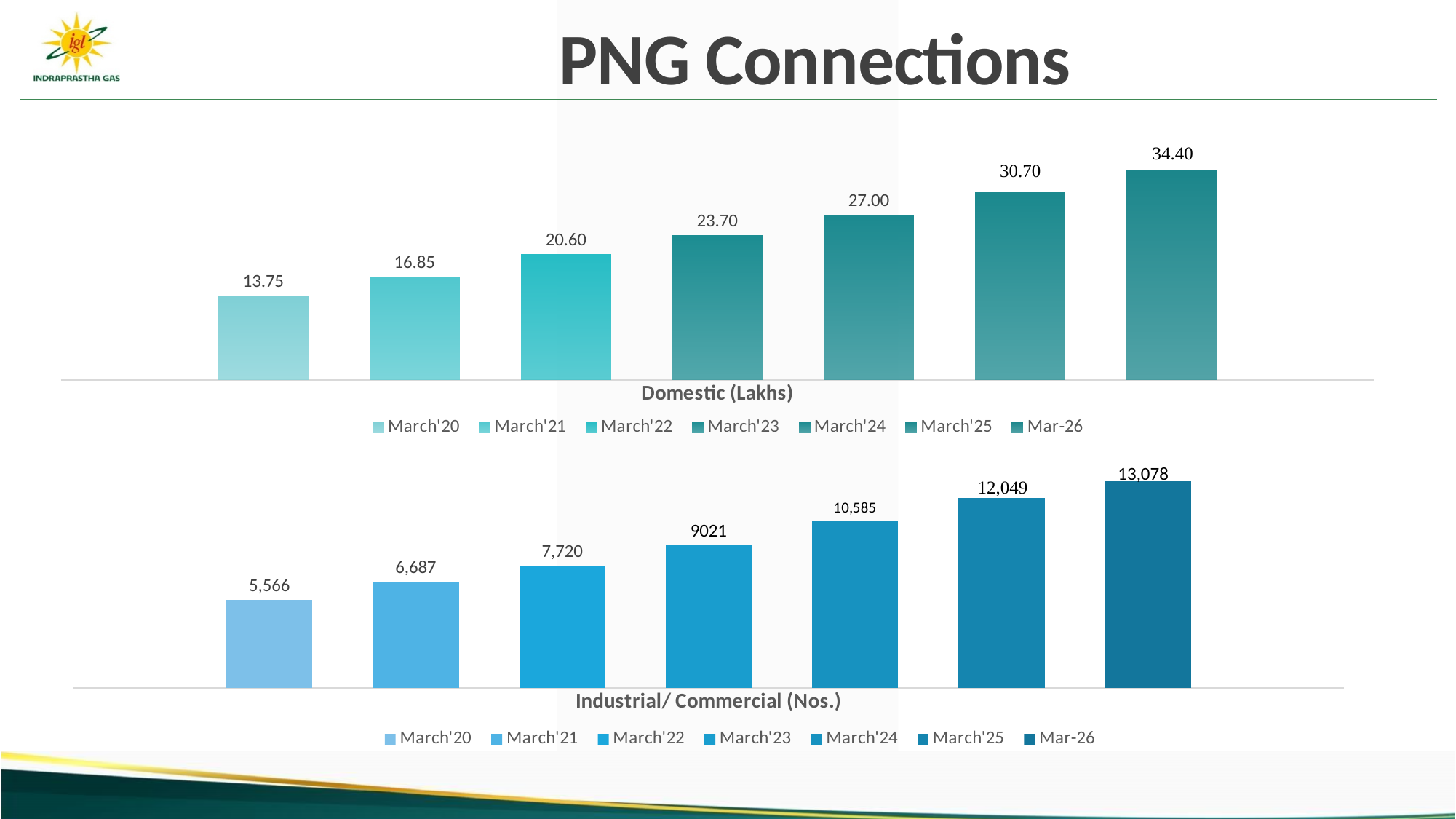
In the Industrial/ Commercial (Nos.) chart, what is the difference between the March'25 and March'24 values? 1,464 In the Industrial/ Commercial (Nos.) chart, what is the value for March'20? 5,566 In the Industrial/ Commercial (Nos.) chart, what is the value for March'23? 9021 In the Domestic (Lakhs) chart, which is larger, the value for March'23 or the value for March'21? March'23 In the Domestic (Lakhs) chart, what is the value for March'22? 20.60 What kind of chart is the Domestic (Lakhs) chart? Bar chart In the Domestic (Lakhs) chart, which series has the lowest value? March'20 How many series does the legend of the Industrial/ Commercial (Nos.) chart list? 7 In the Industrial/ Commercial (Nos.) chart, which series has the highest value? Mar-26 In the Domestic (Lakhs) chart, what is the difference between the Mar-26 and March'25 values? 3.70 In the Industrial/ Commercial (Nos.) chart, do the values rise or fall from March'20 to Mar-26? Rise In the Domestic (Lakhs) chart, what is the value for Mar-26? 34.40